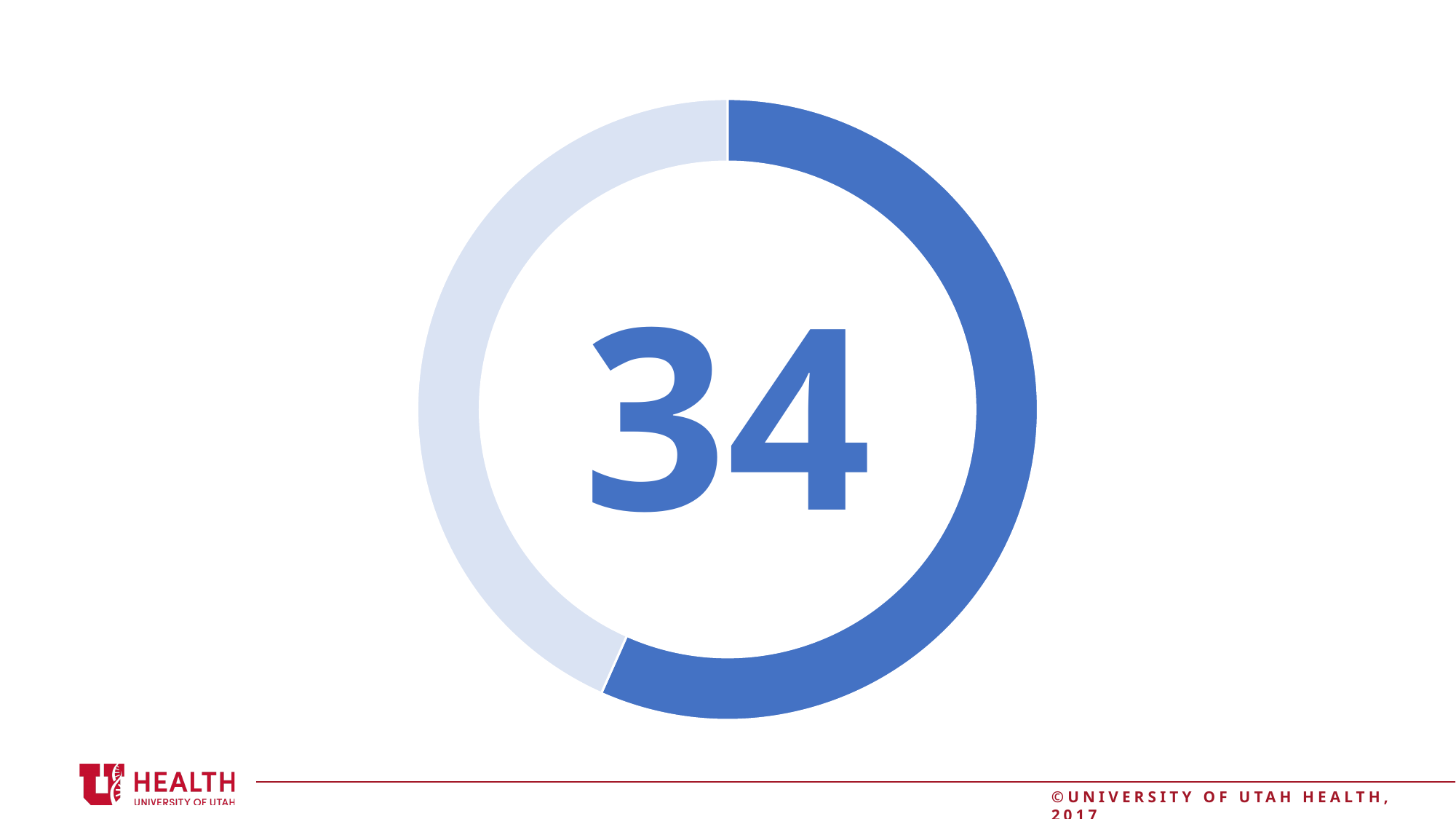
Which colour segment is the smallest in the doughnut chart? Light blue Which colour segment is the largest in the doughnut chart? Dark blue What kind of chart is shown on the slide? Doughnut chart Does the doughnut chart have a legend? No How many segments does the doughnut chart have? 2 What colour is the text in the centre of the doughnut chart? Blue Does the dark blue segment cover more or less than half of the ring? More What number is displayed in the centre of the doughnut chart? 34 Which segment of the doughnut chart is larger, the dark blue one or the light blue one? Dark blue